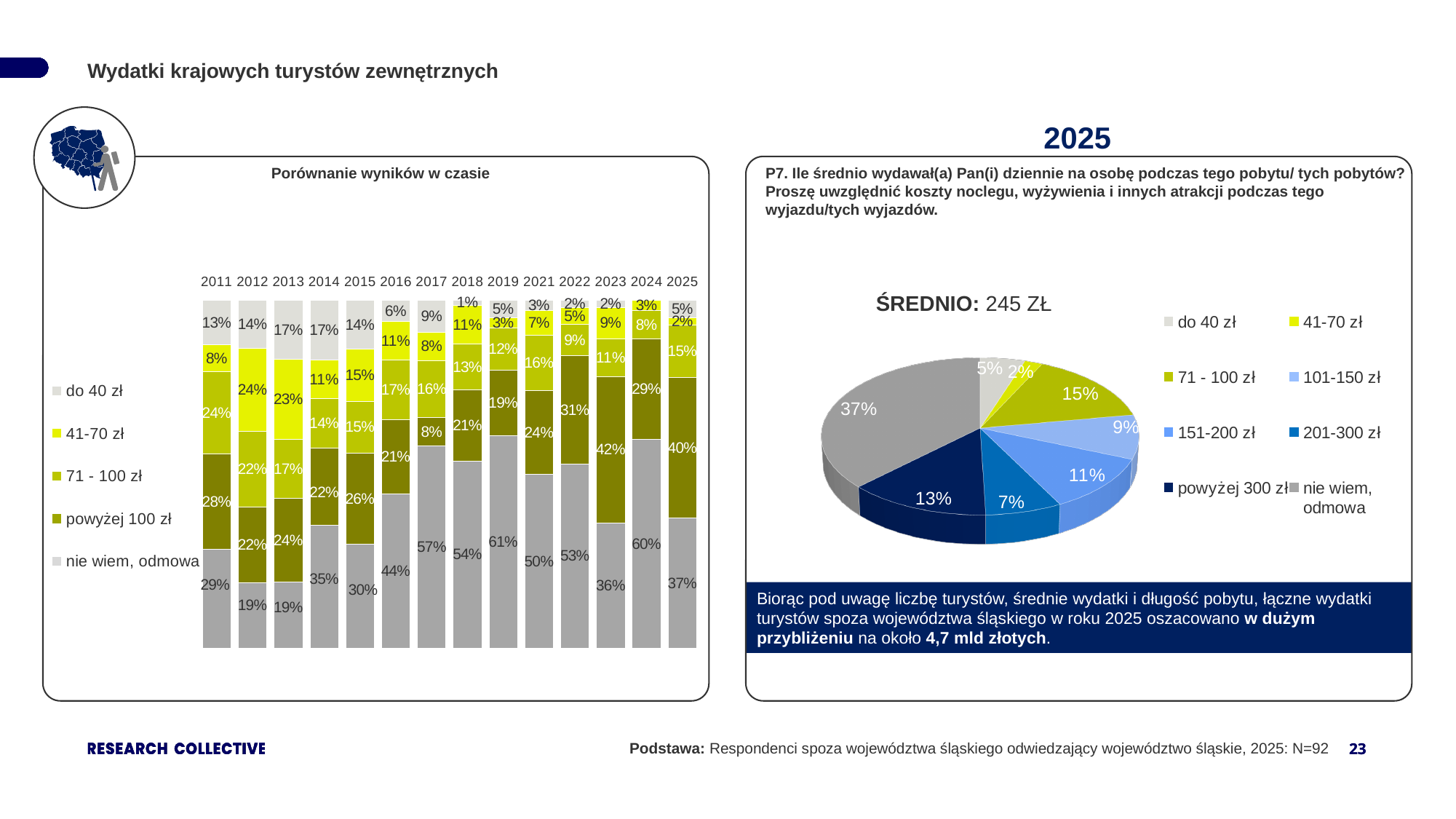
In the pie chart on the right, what share of respondents answered "nie wiem, odmowa"? 37% In the chart "Porównanie wyników w czasie", what is the value for "powyżej 100 zł" in 2023? 42% In the chart "Porównanie wyników w czasie", what is the difference between the "powyżej 100 zł" value in 2025 and in 2017? 32 percentage points How many categories does the legend of the pie chart on the right list? 8 In the chart "Porównanie wyników w czasie", what is the value for "nie wiem, odmowa" in 2019? 61% How many years (bars) are shown in the chart "Porównanie wyników w czasie"? 14 In the pie chart on the right, what is the share for "71 - 100 zł"? 15% In the pie chart on the right, which category has the smallest slice? 41-70 zł How many series does the legend of the chart "Porównanie wyników w czasie" list? 5 In the pie chart on the right, which category has the largest slice? nie wiem, odmowa What kind of chart is "Porównanie wyników w czasie"? Stacked bar chart What average value (ŚREDNIO) is shown above the pie chart on the right? 245 ZŁ